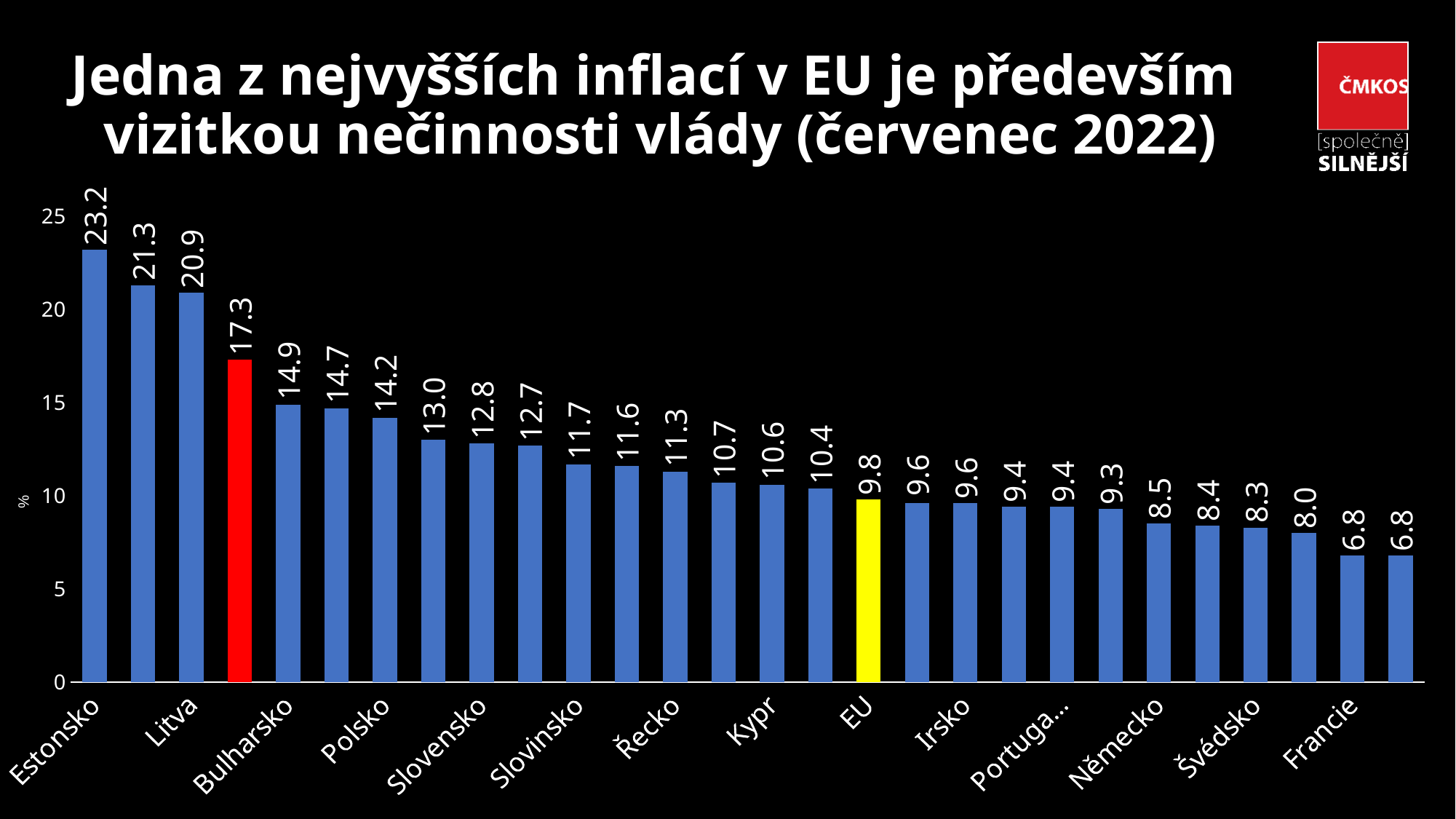
Which is larger, the value for Polsko or the value for Slovensko? Polsko Do the values rise or fall from left to right along the x axis? fall How many bars are plotted in the chart? 28 Is the value for Litva greater or less than 20? greater What kind of chart is shown on the slide? bar chart What is the value for Polsko? 14.2 Which category has the highest value? Estonsko What is the value for Francie? 6.8 What is the value for Estonsko? 23.2 What is the value for EU? 9.8 What is the value for Německo? 8.5 What is the difference between the values for Estonsko and EU? 13.4